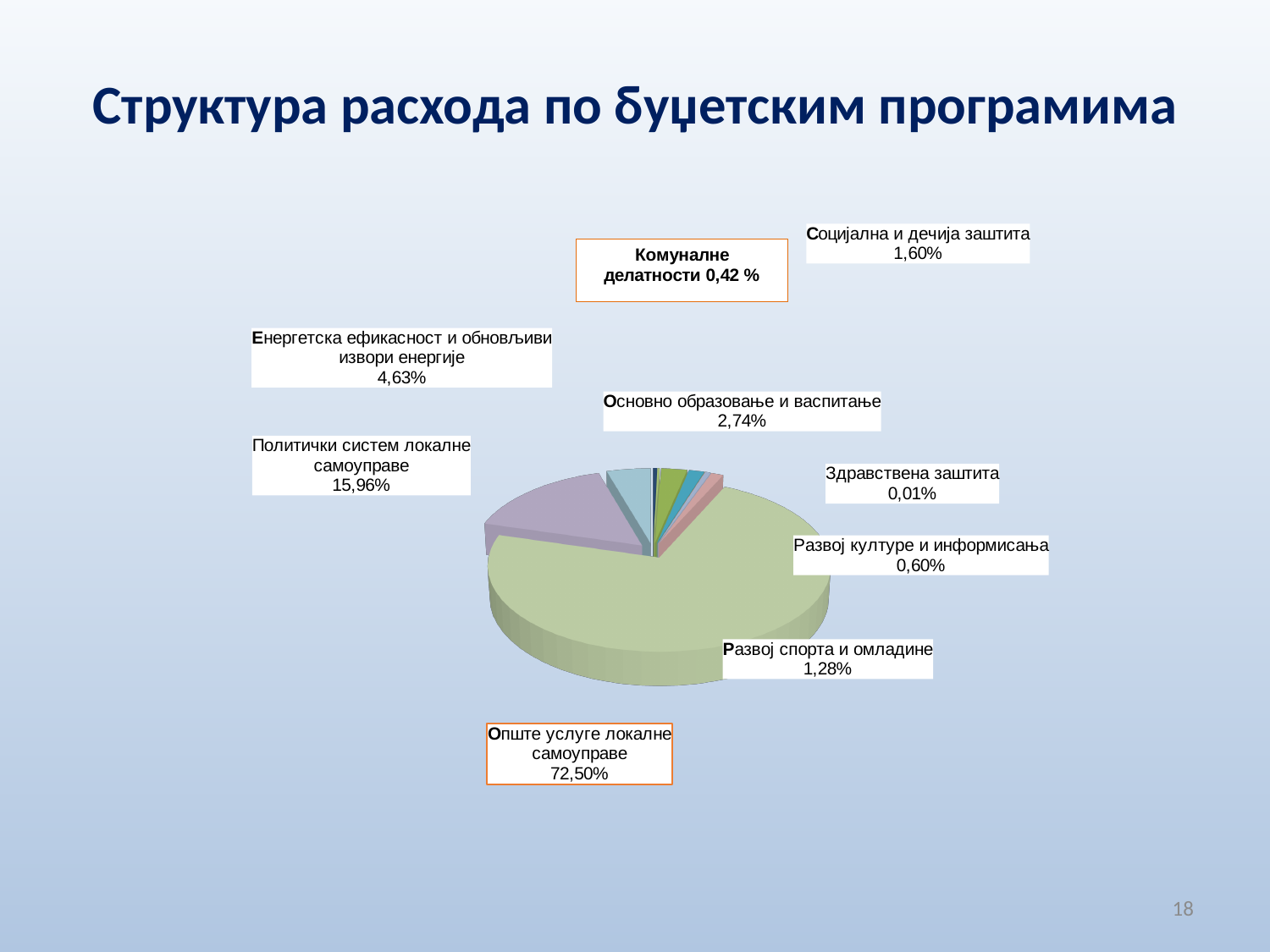
How many categories are labelled in the pie chart? 9 What is the value shown for Политички систем локалне самоуправе? 15,96% What share does Опште услуге локалне самоуправе have in the pie chart? 72,50% Which category has the smallest share of the pie? Здравствена заштита What kind of chart is shown on the slide? Pie chart What is the title of the chart on the slide? Структура расхода по буџетским програмима What is the value for Основно образовање и васпитање? 2,74% Which category has the largest share of the pie? Опште услуге локалне самоуправе Which is larger: Социјална и дечија заштита or Развој спорта и омладине? Социјална и дечија заштита What percentage is shown for Енергетска ефикасност и обновљиви извори енергије? 4,63% What is the difference between the shares of Политички систем локалне самоуправе and Енергетска ефикасност и обновљиви извори енергије? 11,33% What percentage is labelled for Комуналне делатности? 0,42 %